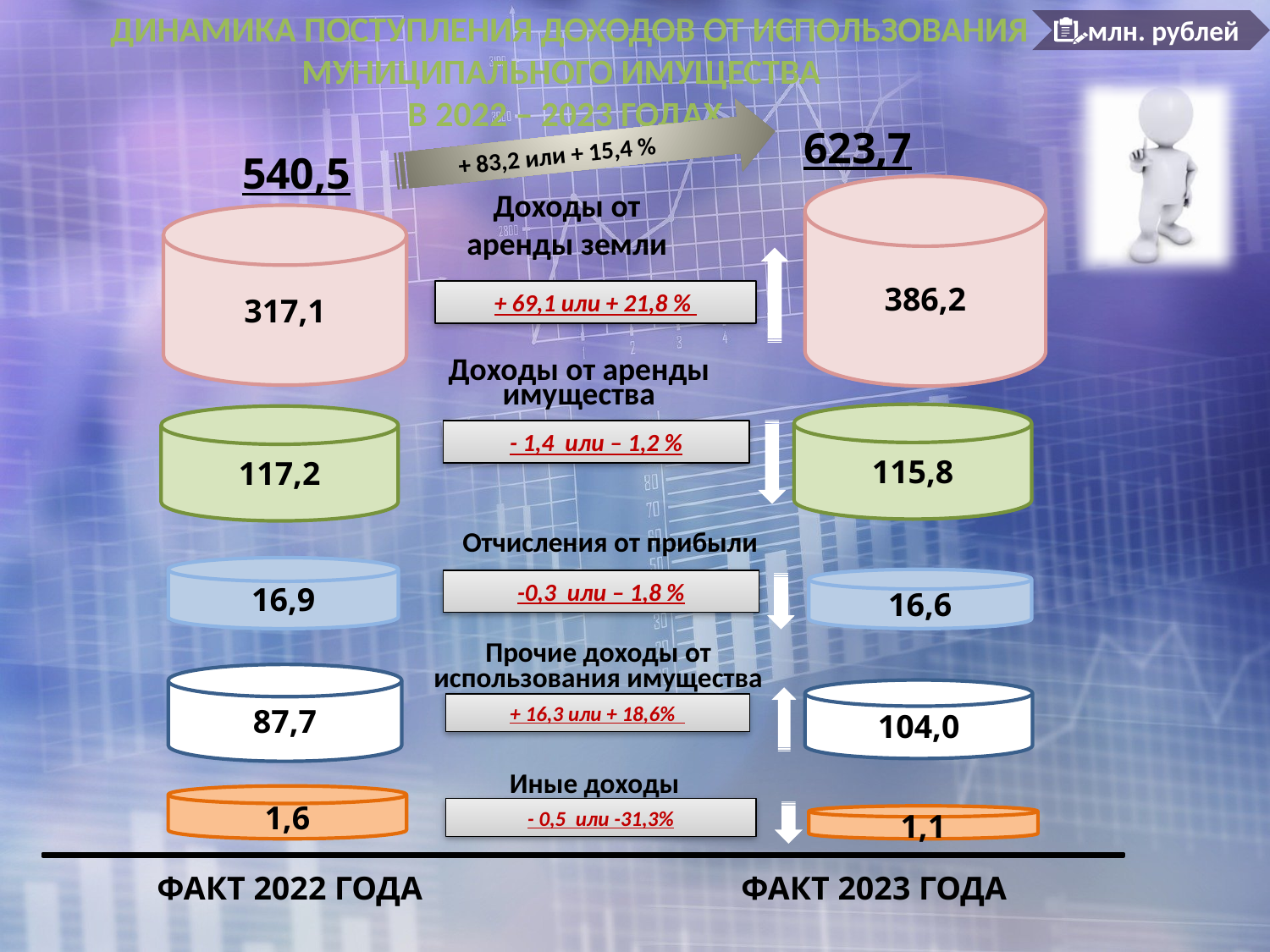
Каков объём отчислений от прибыли по факту 2023 года? 16,6 Какая категория доходов имеет наибольшее значение по факту 2022 года? Доходы от аренды земли Какова общая сумма доходов от использования муниципального имущества по факту 2023 года? 623,7 Сколько категорий доходов показано на слайде? 5 В каких единицах измерения приведены значения на слайде? млн. рублей Какая категория доходов имеет наименьшее значение по факту 2023 года? Иные доходы На сколько изменилась общая сумма доходов с 2022 по 2023 год? + 83,2 или + 15,4 % Какова общая сумма доходов от использования муниципального имущества по факту 2022 года? 540,5 На сколько изменились прочие доходы от использования имущества с 2022 по 2023 год? + 16,3 или + 18,6% Каков объём доходов от аренды имущества по факту 2022 года? 117,2 Каков объём доходов от аренды земли по факту 2023 года? 386,2 Что больше: доходы от аренды имущества в 2022 году или в 2023 году? В 2022 году